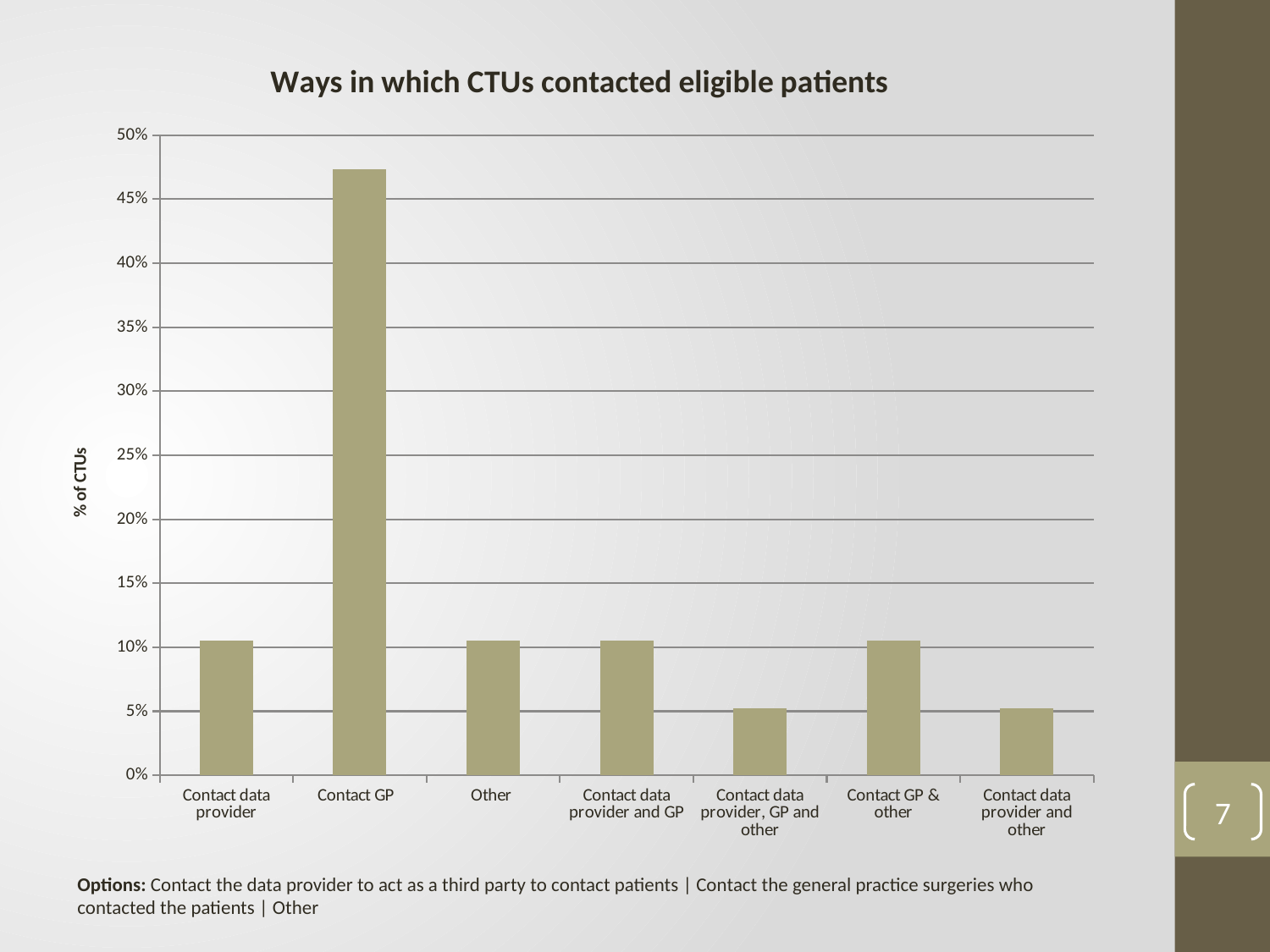
Is the value for Contact data provider and other greater or less than 10%? less Which is larger, the value for Contact GP or the value for Other? Contact GP How many categories are shown on the x axis of the chart? 7 What is the title of the chart? Ways in which CTUs contacted eligible patients Is the value for Contact data provider, GP and other greater or less than 10%? less Which category has the highest value in the chart? Contact GP Is the value for Contact GP greater or less than 45%? greater What is the label on the vertical axis of the chart? % of CTUs Which is larger, the value for Contact GP & other or the value for Contact data provider, GP and other? Contact GP & other What type of chart is shown on the slide? bar chart